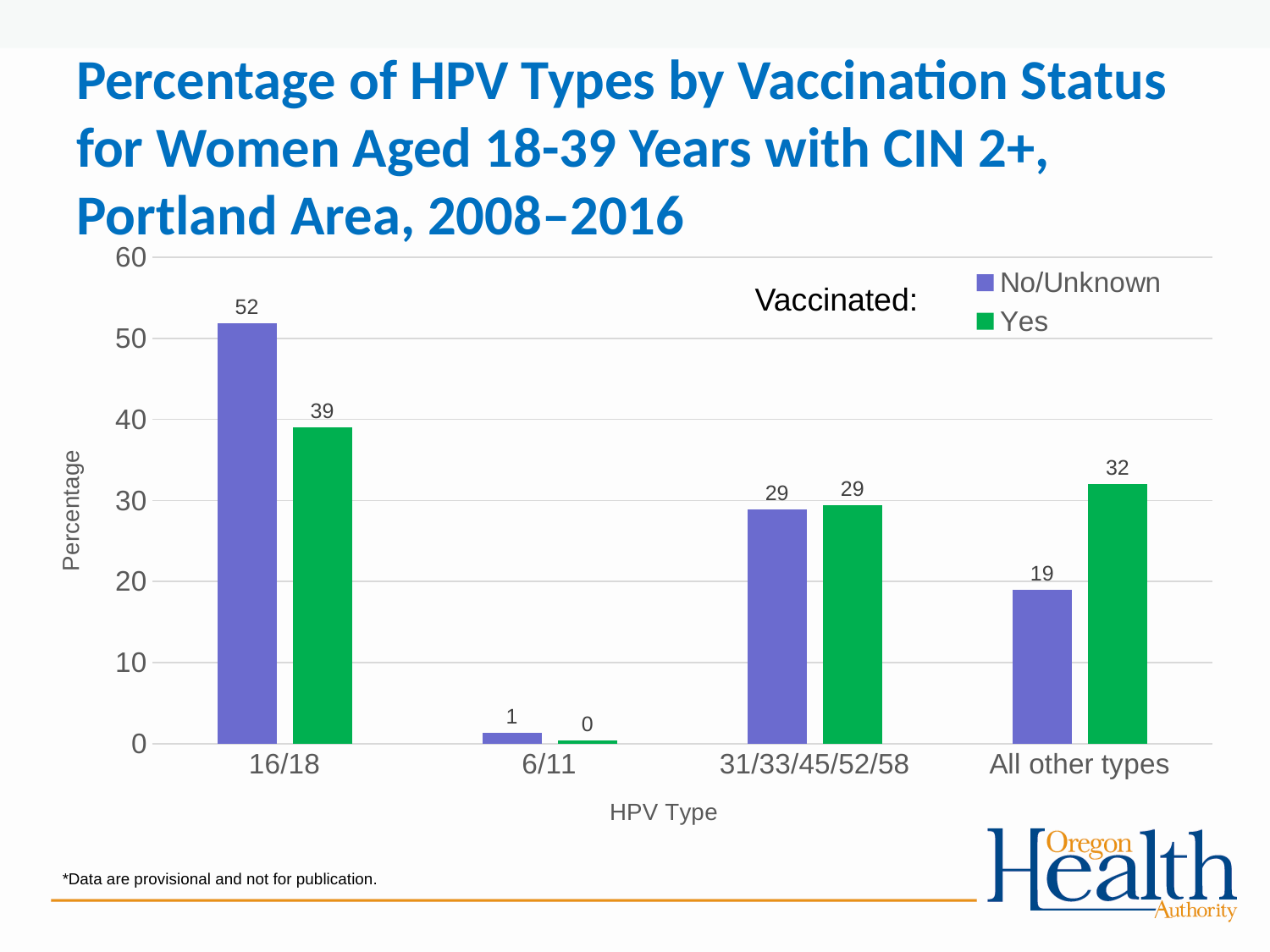
What is the difference between the No/Unknown and Yes values for HPV type 16/18? 13 For All other types, which is larger: the No/Unknown value or the Yes value? Yes What is the Yes (vaccinated) value for All other types? 32 What kind of chart is shown on the slide? Bar chart What is the No/Unknown value for HPV type 16/18? 52 What is the No/Unknown value for HPV type 6/11? 1 What is the label of the y axis? Percentage How many HPV type categories are shown on the x axis? 4 Which HPV type has the highest No/Unknown value? 16/18 How many series does the legend list? 2 Which HPV type has the lowest Yes (vaccinated) value? 6/11 What is the Yes (vaccinated) value for HPV type 16/18? 39